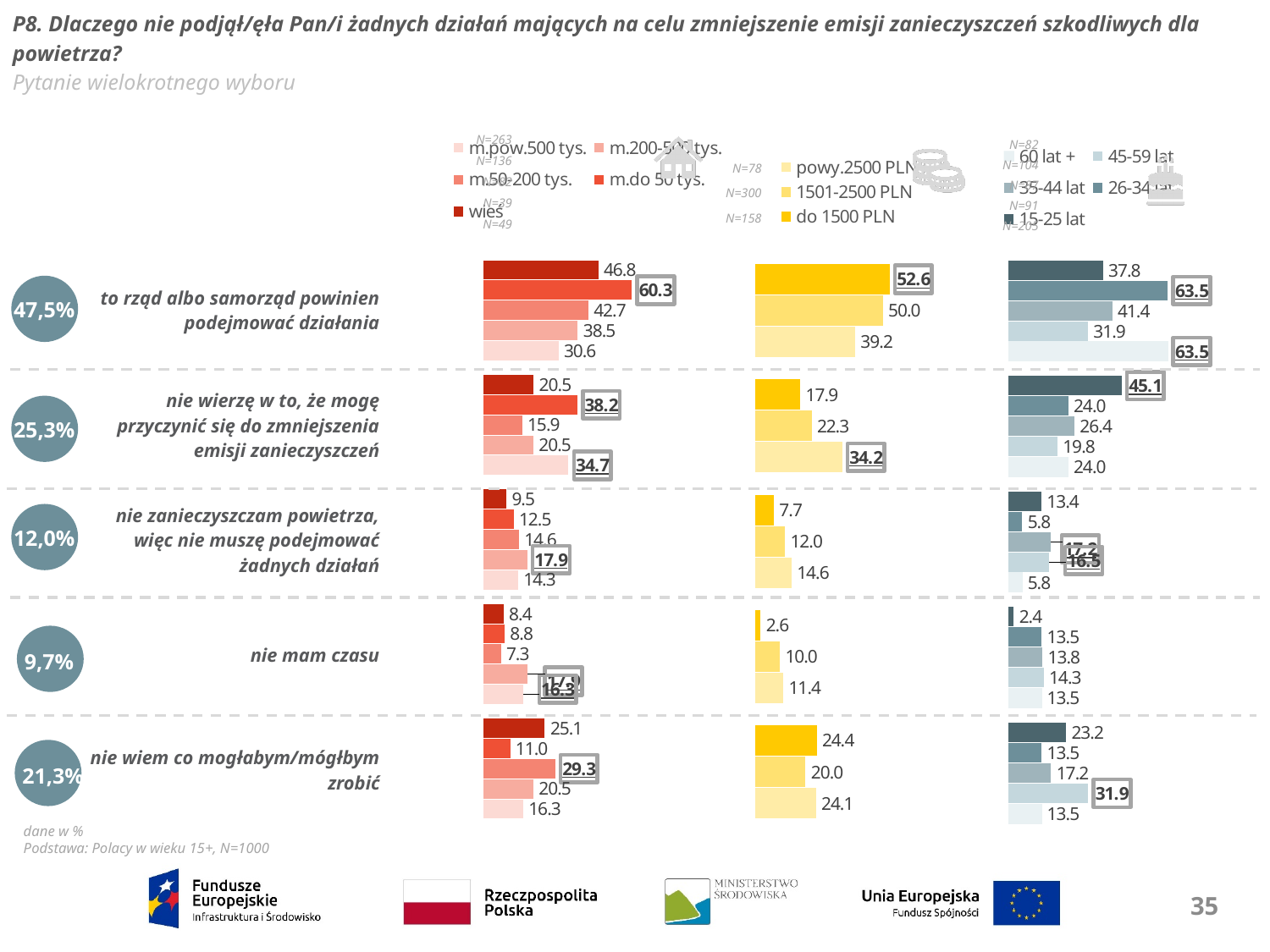
In the age-group chart, which is larger for the reason 'nie wierzę w to, że mogę przyczynić się do zmniejszenia emisji zanieczyszczeń': the value for '15-25 lat' or for '45-59 lat'? 15-25 lat In the income-group chart, what is the value for 'powy.2500 PLN' for the reason 'nie wierzę w to, że mogę przyczynić się do zmniejszenia emisji zanieczyszczeń'? 34.2 What overall percentage is shown in the circle next to the reason 'nie mam czasu'? 9,7% In the income-group chart, which income group has the lowest value for the reason 'nie mam czasu'? do 1500 PLN In the income-group chart (do 1500 PLN / 1501-2500 PLN / powy.2500 PLN), what is the value for 'do 1500 PLN' for the reason 'to rząd albo samorząd powinien podejmować działania'? 52.6 In the place-of-residence chart, what is the value for 'wieś' for the reason 'nie wiem co mogłabym/mógłbym zrobić'? 25.1 How many income groups does the legend of the income-group chart list? 3 What type of chart is used on this slide to show the results by place of residence, income and age? bar chart In the income-group chart, what is the difference between 'do 1500 PLN' and 'powy.2500 PLN' for the reason 'to rząd albo samorząd powinien podejmować działania'? 13.4 How many age groups does the legend of the age-group chart list? 5 In the place-of-residence chart, which residence category has the highest value for the reason 'to rząd albo samorząd powinien podejmować działania'? m.do 50 tys. In the age-group chart, what is the value for '45-59 lat' for the reason 'nie wiem co mogłabym/mógłbym zrobić'? 31.9